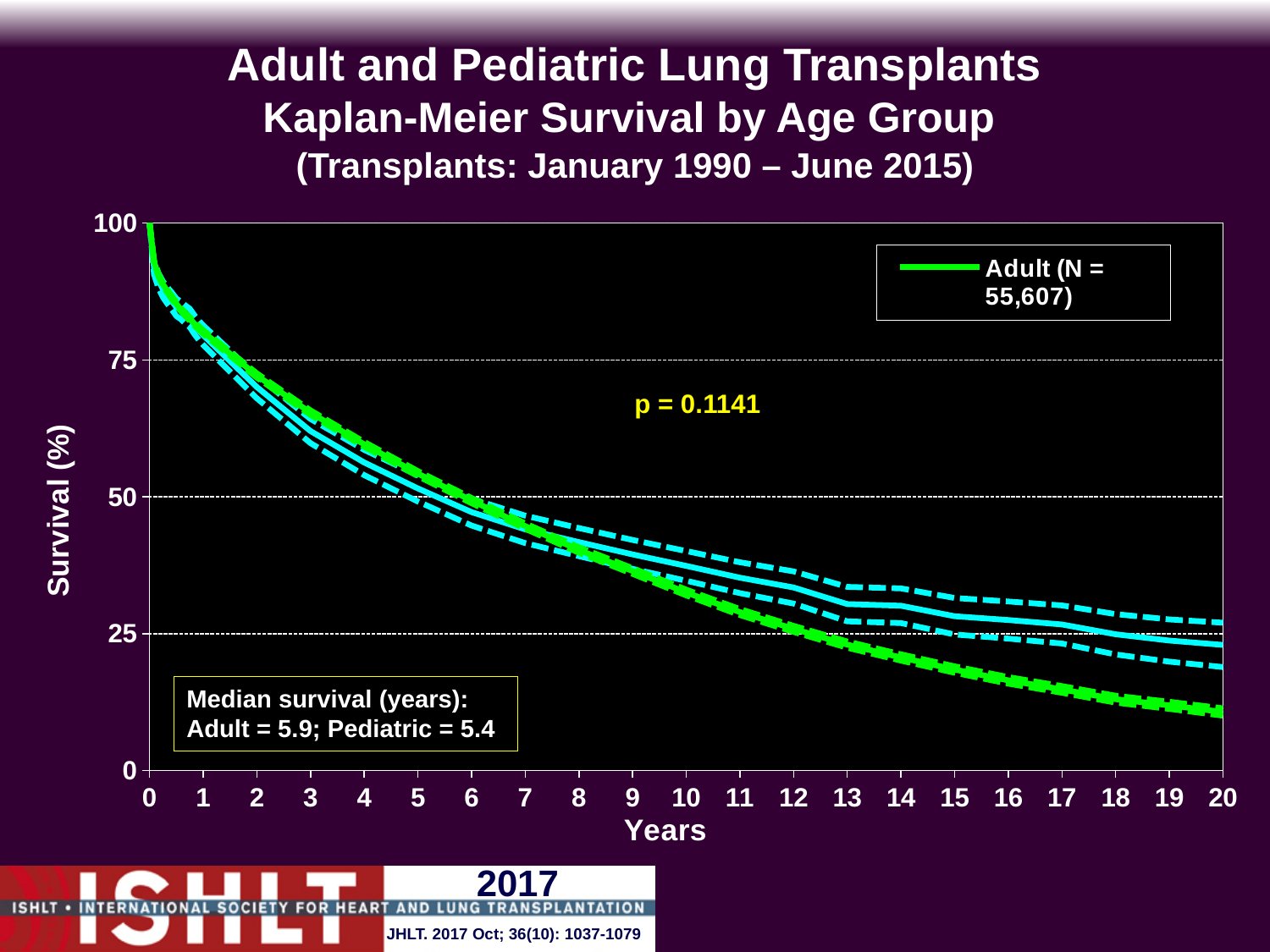
What is the p-value shown on the chart? p = 0.1141 How many series does the legend list? 1 Is the Adult survival value at 1 year greater or less than 75? greater Is the cyan survival curve at 10 years greater or less than 25? greater What is the median survival in years for the Adult group? 5.9 At 20 years, which curve is higher, the green Adult curve or the cyan curve? the cyan curve Is the Adult survival value at 20 years greater or less than 25? less What is the median survival in years for the Pediatric group? 5.4 Does the Adult survival curve rise or fall as the years increase? fall Which group has the longer median survival, Adult or Pediatric? Adult What is the difference in median survival (years) between the Adult and Pediatric groups? 0.5 What kind of chart is shown on the slide? line chart